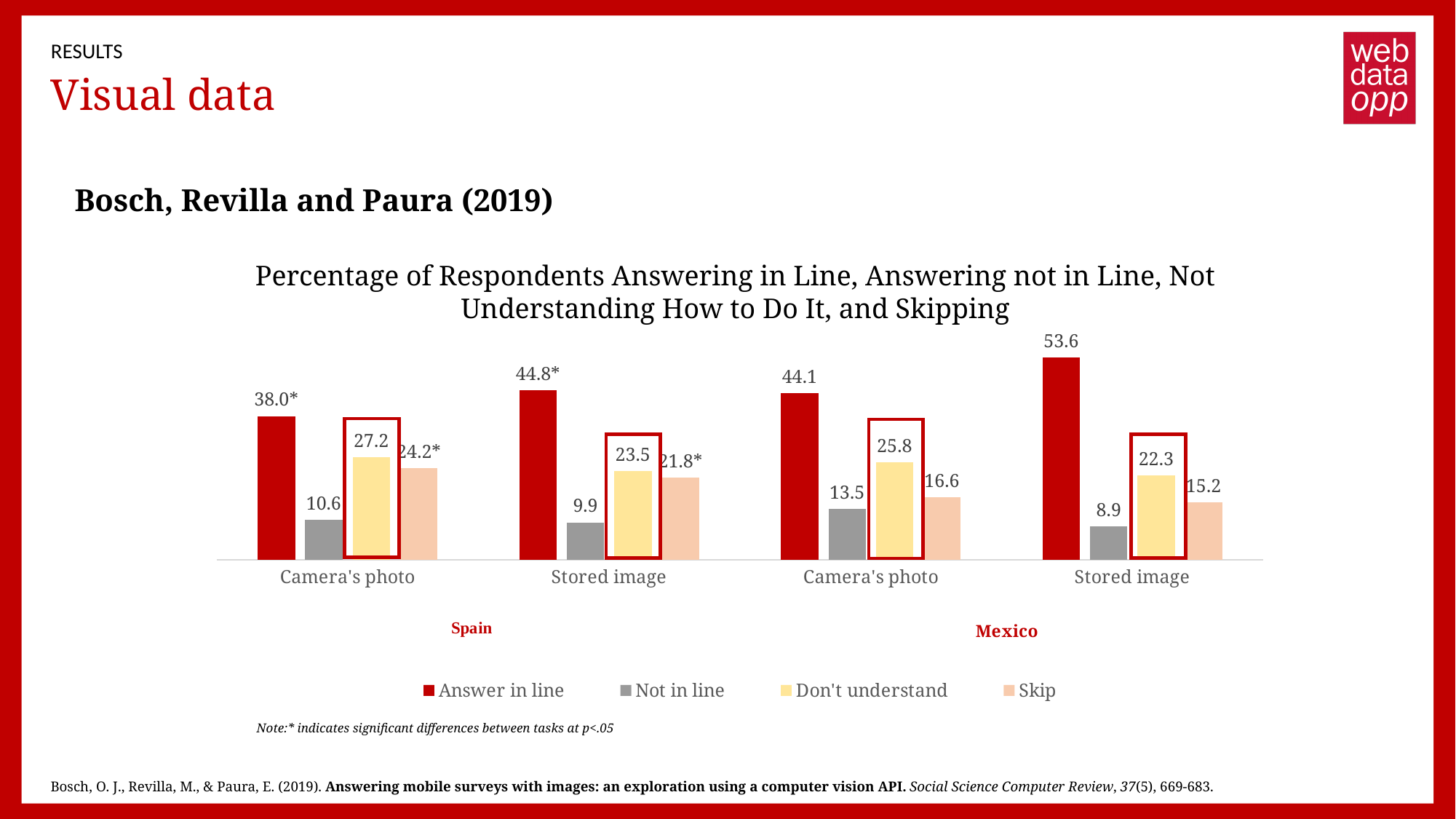
How many series does the legend list? 4 What is the difference between the "Answer in line" values for Stored image and Camera's photo in Spain? 6.8 What is the value for "Not in line" for the Stored image task in Spain? 9.9 What is the value for "Skip" for the Camera's photo task in Mexico? 16.6 How many task groups (category groups) are shown on the x axis? 4 What is the value for "Don't understand" for the Camera's photo task in Spain? 27.2 What kind of chart is shown on the slide? Bar chart Which task and country has the highest "Answer in line" value? Stored image, Mexico What percentage of respondents answered in line for the Stored image task in Mexico? 53.6 Which is larger: the "Skip" value for Camera's photo in Spain or for Stored image in Spain? Camera's photo in Spain Which task and country has the lowest "Not in line" value? Stored image, Mexico Which series is shown in red in the chart? Answer in line